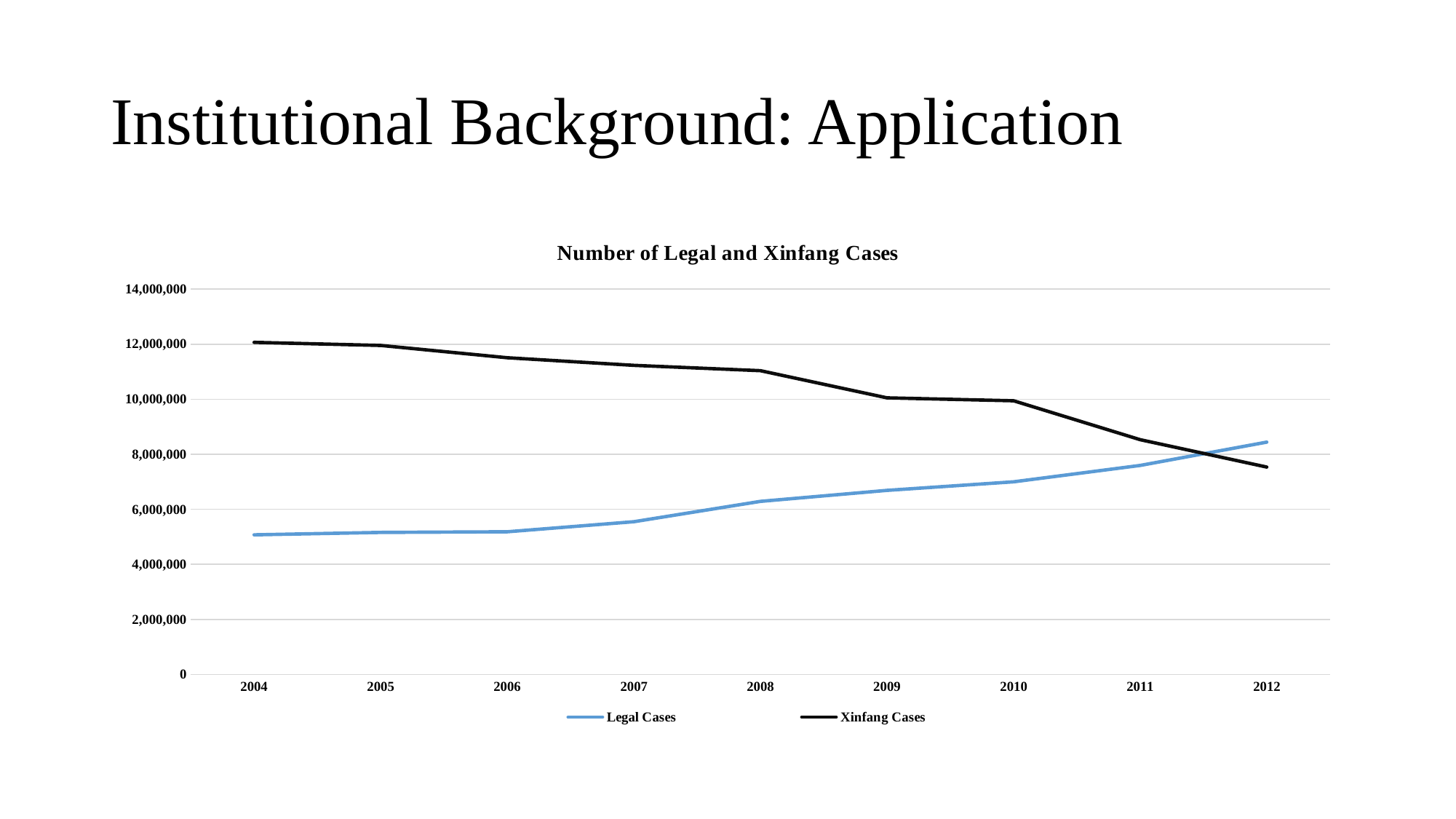
What is the title of the chart? Number of Legal and Xinfang Cases What kind of chart is shown on the slide? line chart Do the Legal Cases values rise or fall from 2004 to 2012? rise Do the Xinfang Cases values rise or fall from 2004 to 2012? fall Is the value for Xinfang Cases in 2012 greater or less than 8,000,000? less How many series does the legend list? 2 In which year is the Legal Cases value highest? 2012 In 2012, which series has the higher value, Legal Cases or Xinfang Cases? Legal Cases How many years are plotted along the x axis? 9 In which year is the Xinfang Cases value lowest? 2012 Which colour is used for the Xinfang Cases line? black In 2010, which series has the higher value, Legal Cases or Xinfang Cases? Xinfang Cases